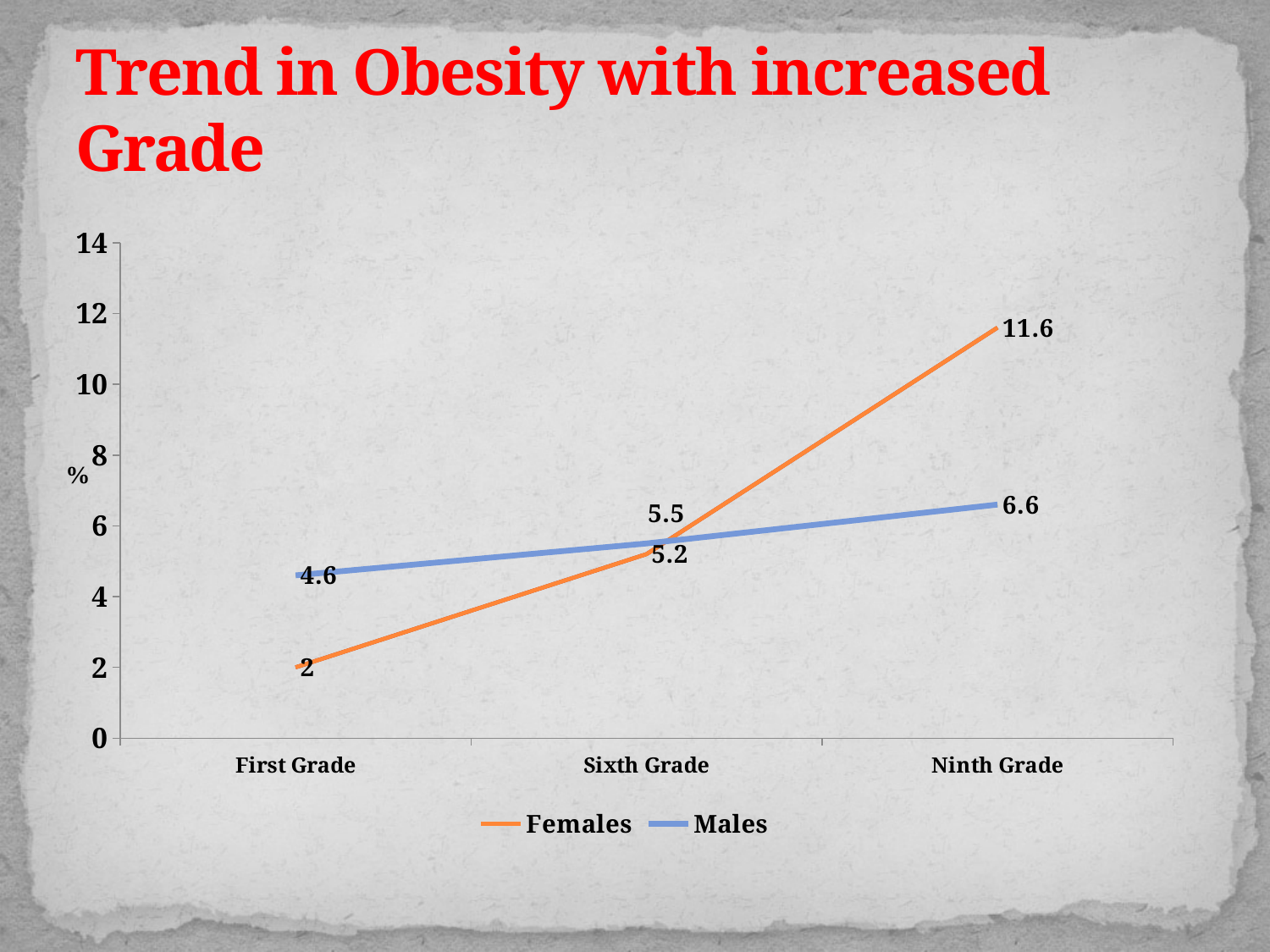
What is the value for Females at First Grade? 2 How many series does the legend list? 2 At which grade is the Males value lowest? First Grade What type of chart is shown on the slide? line chart Do the Females values rise or fall from First Grade to Ninth Grade? rise At which grade is the Females value highest? Ninth Grade What is the value for Males at First Grade? 4.6 At First Grade, which series has the larger value, Females or Males? Males How many grade categories are shown on the x axis? 3 What is the value for Females at Ninth Grade? 11.6 What is the difference between the Females and Males values at Ninth Grade? 5 What is the value for Males at Ninth Grade? 6.6